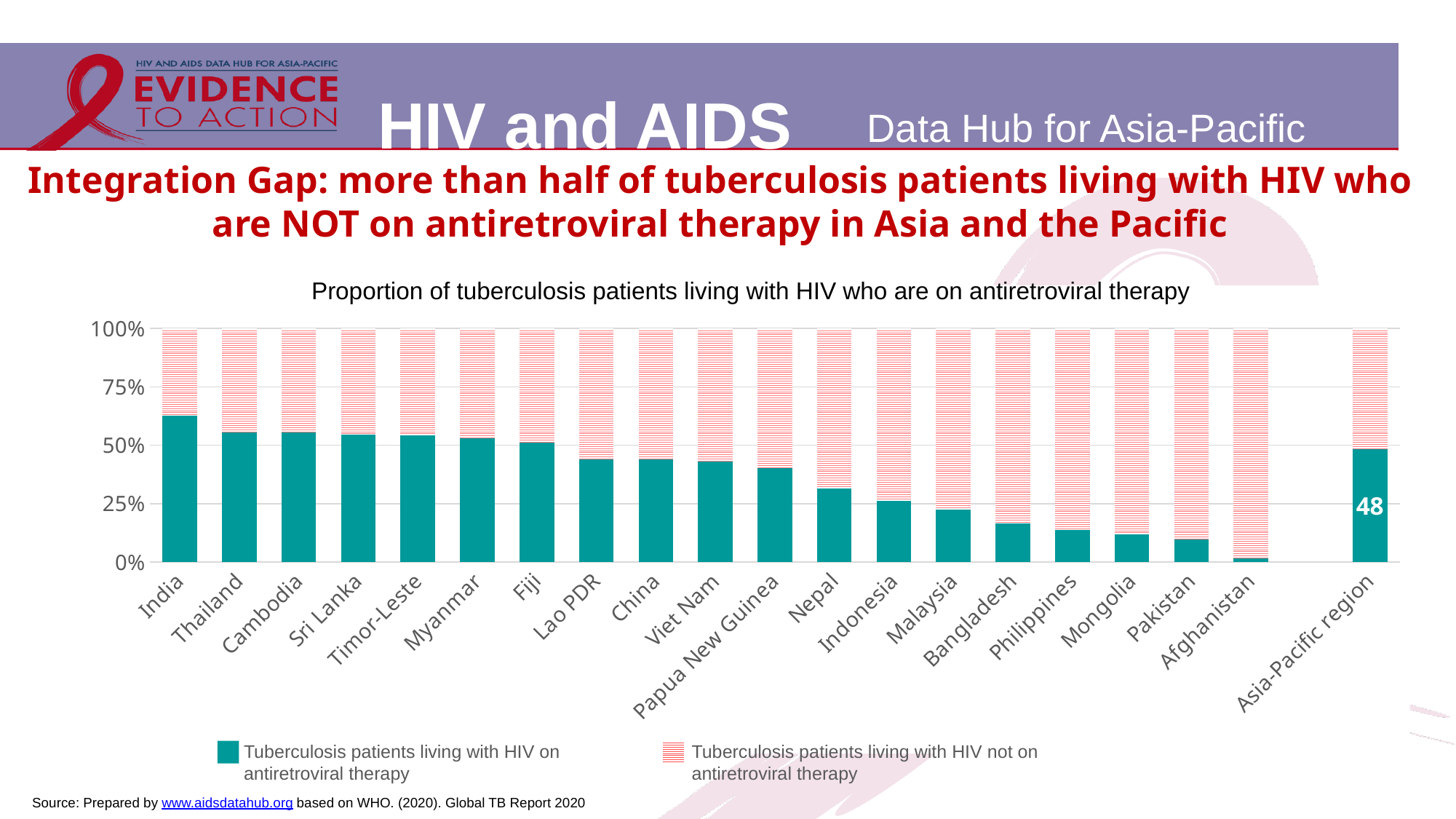
Is the proportion of tuberculosis patients living with HIV on antiretroviral therapy in Pakistan greater or less than 25%? less What value is labelled on the bar for Asia-Pacific region for tuberculosis patients living with HIV on antiretroviral therapy? 48 Which country has the highest proportion of tuberculosis patients living with HIV on antiretroviral therapy? India Is the proportion of tuberculosis patients living with HIV on antiretroviral therapy in Nepal greater or less than 50%? less Which country has the lowest proportion of tuberculosis patients living with HIV on antiretroviral therapy? Afghanistan How many series does the chart legend list? 2 Which has a higher proportion of tuberculosis patients living with HIV on antiretroviral therapy, Nepal or Indonesia? Nepal What kind of chart is shown on the slide? Stacked bar chart Which has a higher proportion of tuberculosis patients living with HIV on antiretroviral therapy, Afghanistan or Mongolia? Mongolia How many categories are shown on the x axis of the chart? 20 Is the proportion of tuberculosis patients living with HIV on antiretroviral therapy in India greater or less than 50%? greater Across the countries from India to Afghanistan, does the proportion on antiretroviral therapy rise or fall along the x axis? Fall